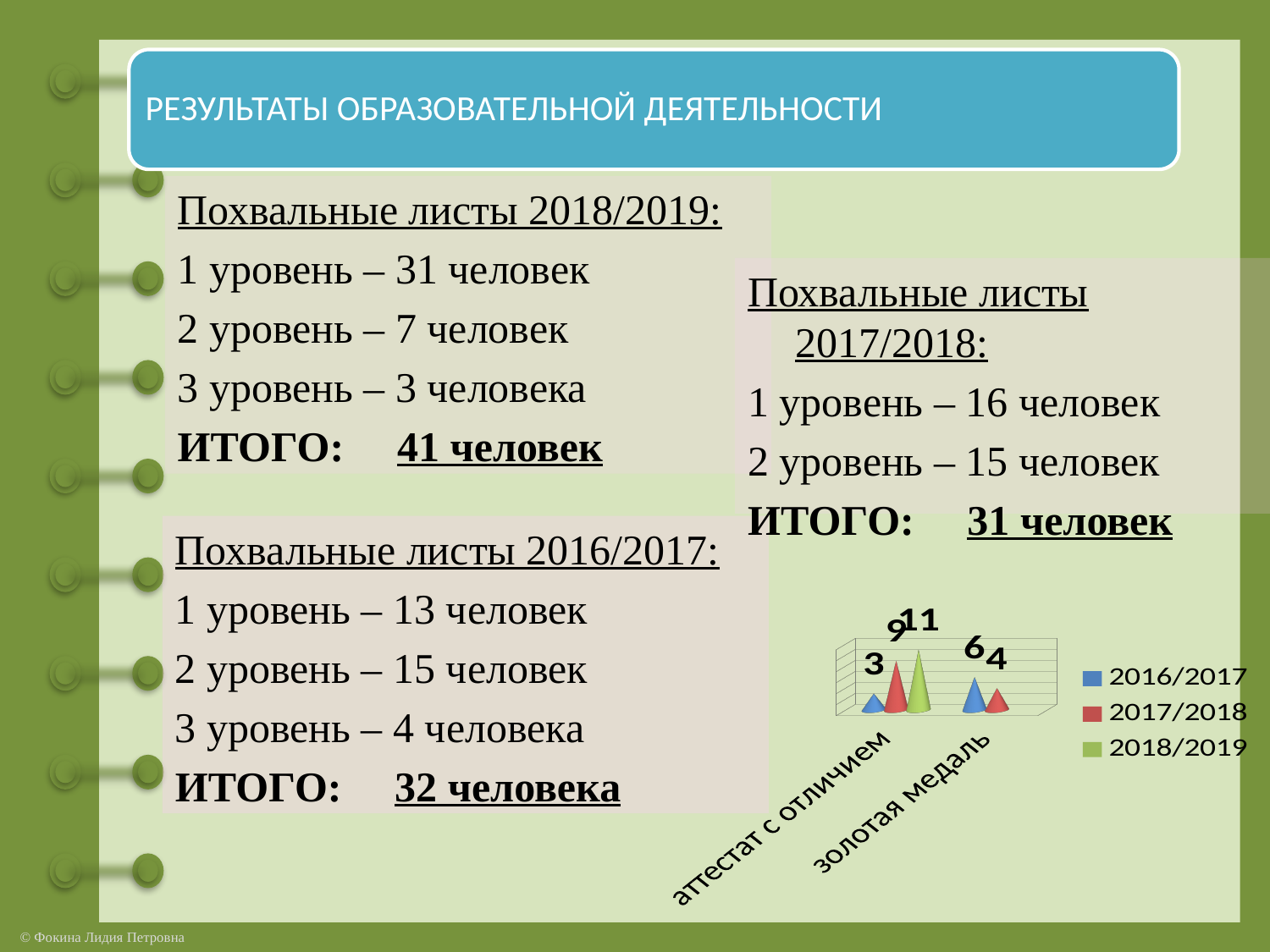
What is the value for 2017/2018 in the 'аттестат с отличием' category? 9 What is the value for 2016/2017 in the 'аттестат с отличием' category? 3 What is the value for 2018/2019 in the 'аттестат с отличием' category? 11 Which year has the lowest value for 'аттестат с отличием'? 2016/2017 What is the value for 2016/2017 in the 'золотая медаль' category? 6 What is the value for 2017/2018 in the 'золотая медаль' category? 4 Which year has the highest value for 'аттестат с отличием'? 2018/2019 How many categories are shown on the chart's x axis? 2 What is the difference between the 2018/2019 and 2016/2017 values for 'аттестат с отличием'? 8 For 2016/2017, which is larger: 'аттестат с отличием' or 'золотая медаль'? золотая медаль What is the difference between the 2016/2017 and 2017/2018 values for 'золотая медаль'? 2 How many series does the chart legend list? 3